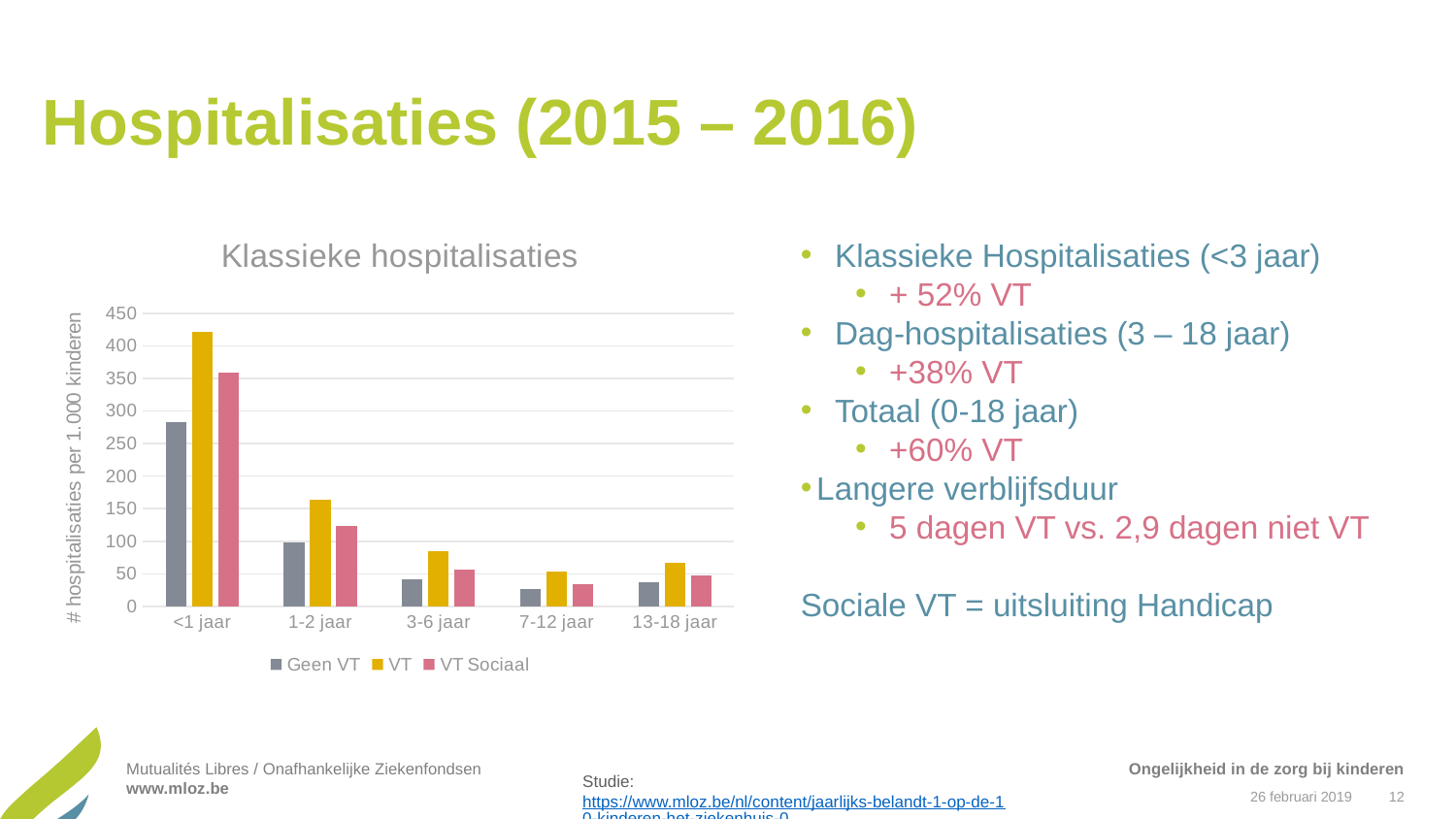
Is the VT value for <1 jaar greater or less than 400? greater What type of chart is shown on the slide? bar chart For the 1-2 jaar category, which is larger: the VT value or the Geen VT value? VT What is the title of the chart? Klassieke hospitalisaties How many age categories are shown on the x axis of the chart? 5 Is the Geen VT value for <1 jaar greater or less than 300? less Which age category has the highest value for the VT series? <1 jaar Is the VT value for 3-6 jaar greater or less than 50? greater How many series does the legend of the chart list? 3 Which age category has the lowest value for the Geen VT series? 7-12 jaar Do the VT values rise or fall from <1 jaar to 7-12 jaar? fall